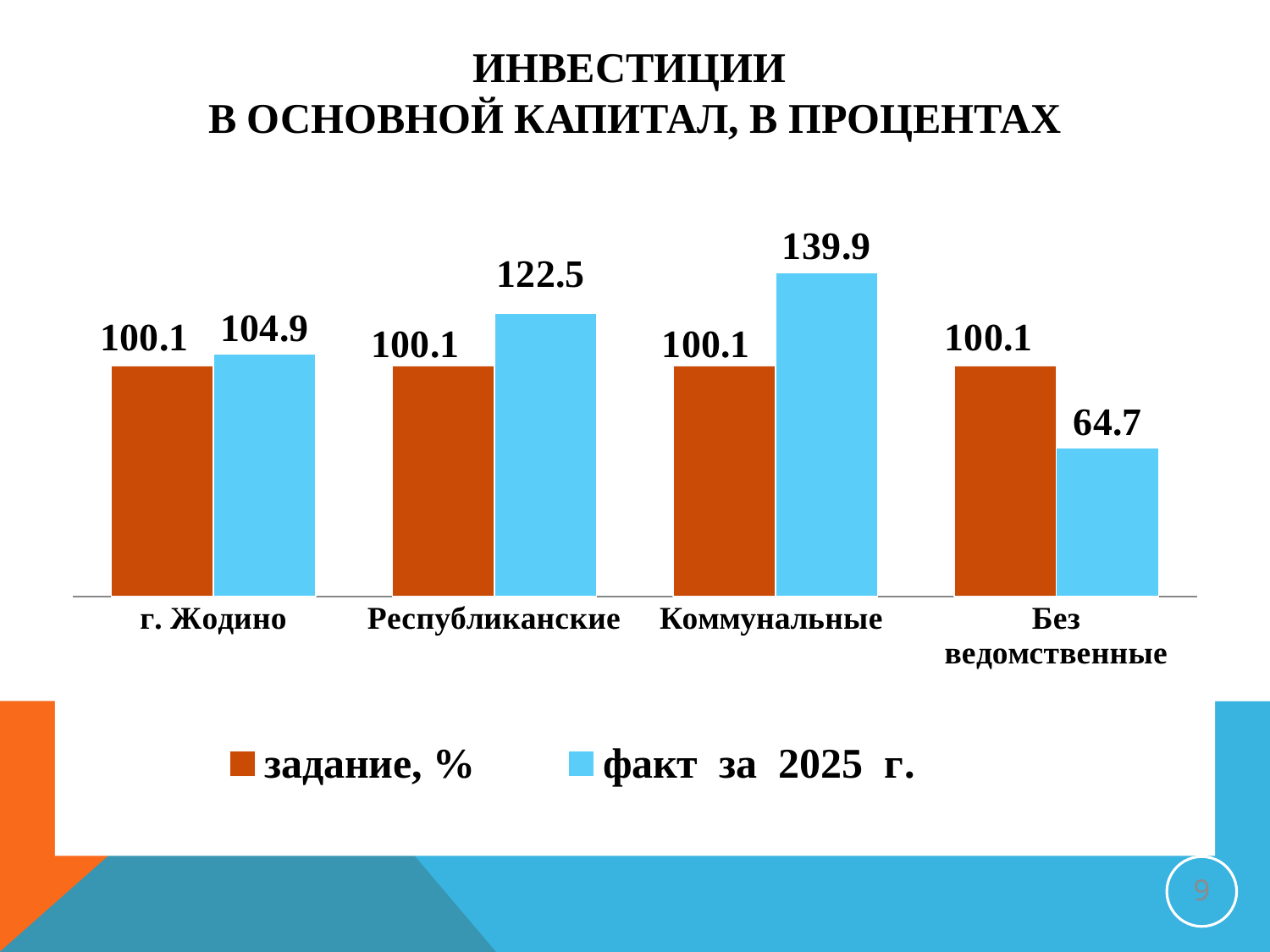
What is the value of "факт за 2025 г." for Коммунальные? 139.9 How many categories are shown on the x axis? 4 What is the value of "факт за 2025 г." for Без ведомственные? 64.7 What is the difference between "факт за 2025 г." and "задание, %" for Республиканские? 22.4 What kind of chart is shown on the slide? Bar chart Which category has the highest "факт за 2025 г." value? Коммунальные Which category has the lowest "факт за 2025 г." value? Без ведомственные What is the value of "факт за 2025 г." for г. Жодино? 104.9 Which colour represents the "факт за 2025 г." series? Light blue What is the value of "задание, %" for Республиканские? 100.1 For Без ведомственные, which is larger: "задание, %" or "факт за 2025 г."? задание, % How many series does the legend list? 2